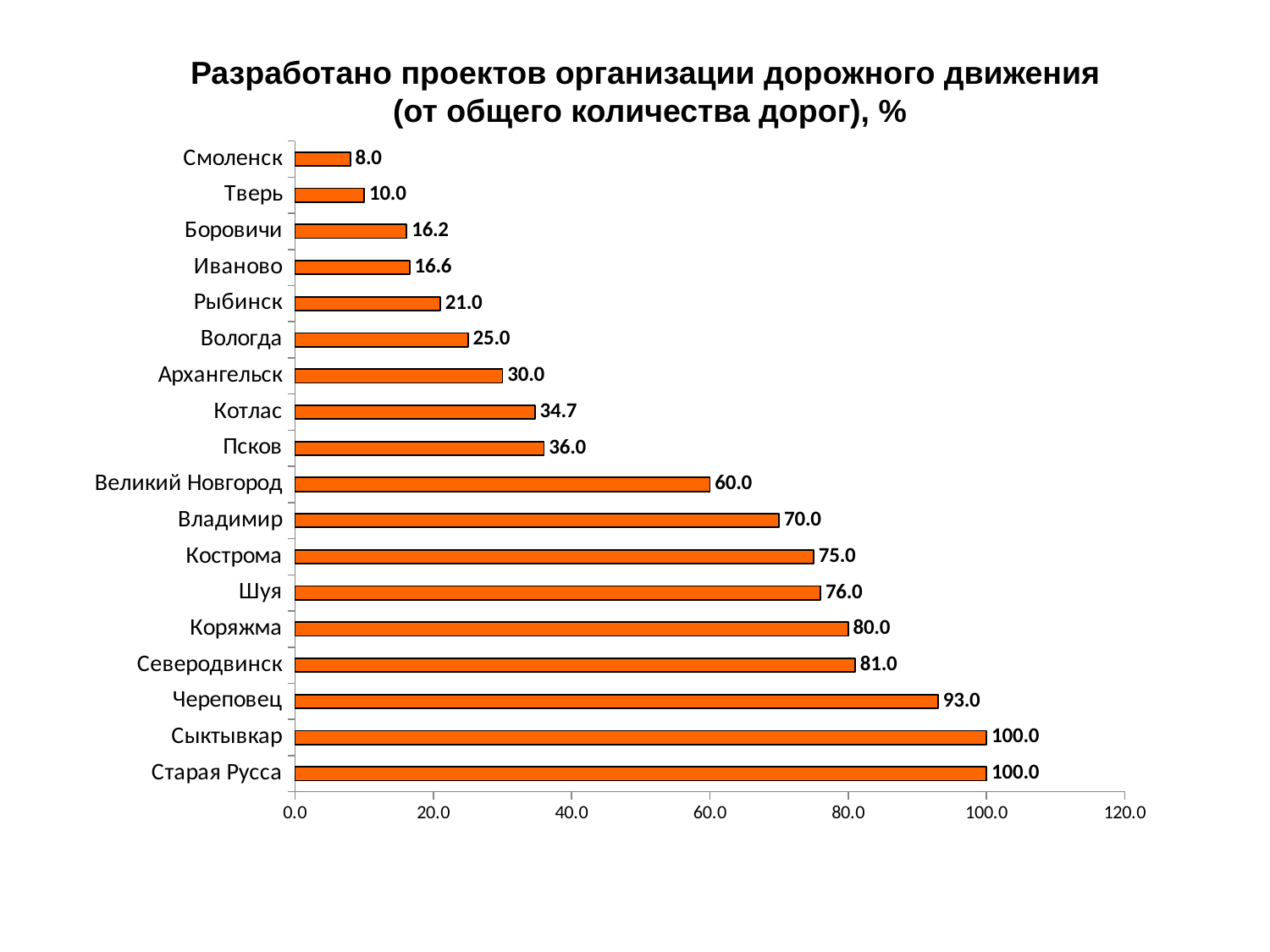
What is the difference between the values for Северодвинск and Коряжма? 1.0 How many cities are shown in the chart? 18 Which has a larger value, Псков or Архангельск? Псков What is the value for Череповец? 93.0 What kind of chart is shown on the slide? bar chart Is the value for Кострома greater or less than 60.0? greater What is the value for Иваново? 16.6 Which has a larger value, Рыбинск or Вологда? Вологда What is the value for Котлас? 34.7 What is the highest value shown on the horizontal axis? 120.0 What is the difference between the values for Владимир and Великий Новгород? 10.0 Which city has the lowest value? Смоленск